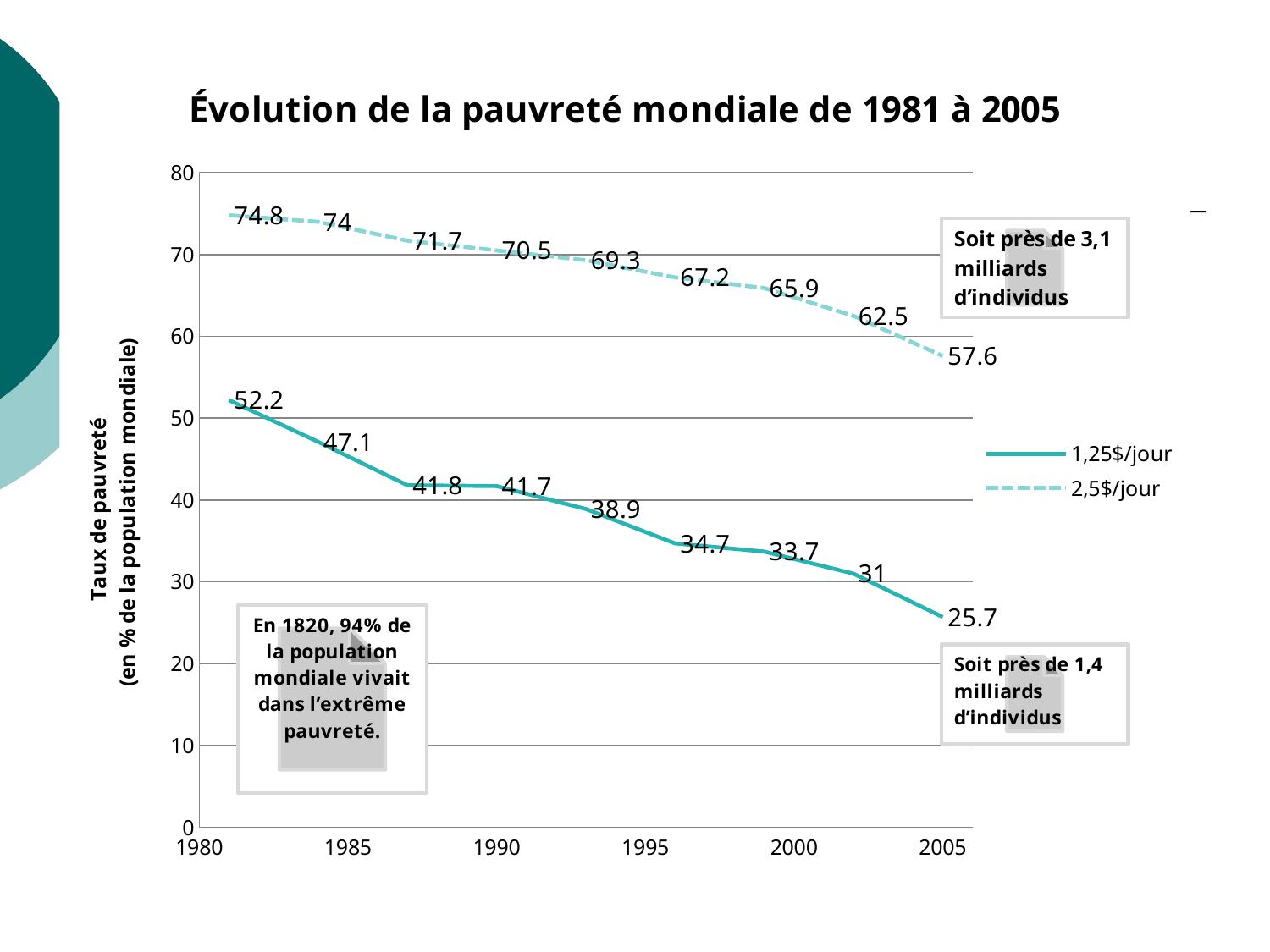
How many series does the legend list? 2 What kind of chart is shown on the slide? line chart What is the difference between the first (74.8) and last (57.6) values of the 2,5$/jour series? 17.2 How many data points are plotted for each series? 9 What is the lowest value plotted for the 2,5$/jour series? 57.6 What is the highest value plotted for the 1,25$/jour series? 52.2 Which series has the higher value in 2005, 1,25$/jour or 2,5$/jour? 2,5$/jour Do the values of the 1,25$/jour series rise or fall from 1981 to 2005? fall What is the value of the 1,25$/jour series at its first point (1981)? 52.2 What is the value of the 1,25$/jour series at its last point (2005)? 25.7 What is the value of the 2,5$/jour series at its last point (2005)? 57.6 What is the value of the 2,5$/jour series at its first point (1981)? 74.8